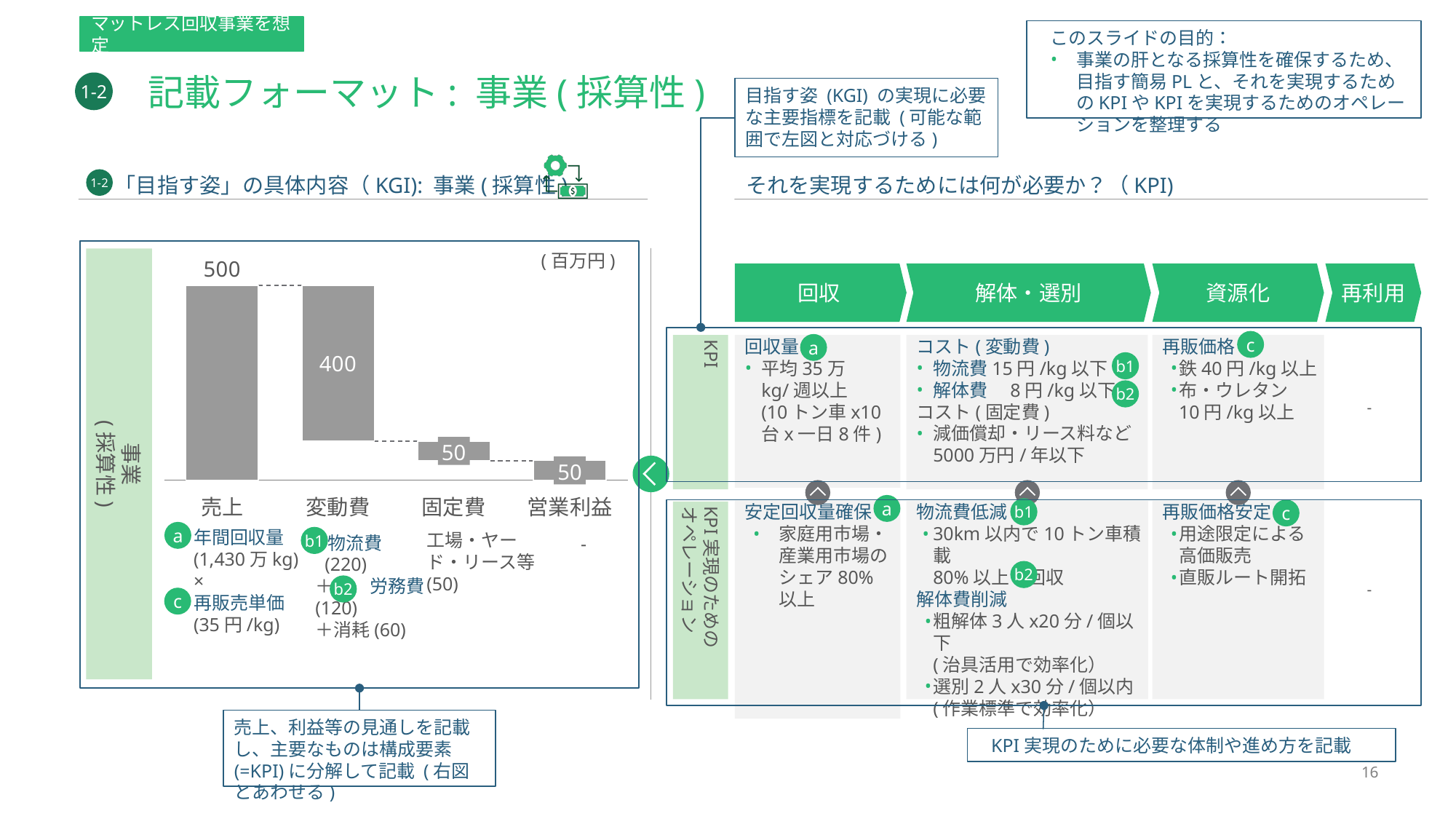
Do the bar values rise or fall from left to right across the chart? Fall What is the value shown for 売上 in the chart? 500 What unit is indicated in the top-right corner of the chart? 百万円 What is the value shown for 営業利益 in the chart? 50 Which category has the highest value in the chart? 売上 What is the difference between the values for 売上 and 変動費? 100 What kind of chart is shown on the slide? Bar chart (waterfall) Which is larger, the value for 変動費 or the value for 固定費? 変動費 What is the difference between the values for 変動費 and 固定費? 350 What is the value shown for 変動費 in the chart? 400 How many categories are shown on the x axis of the chart? 4 What is the value shown for 固定費 in the chart? 50